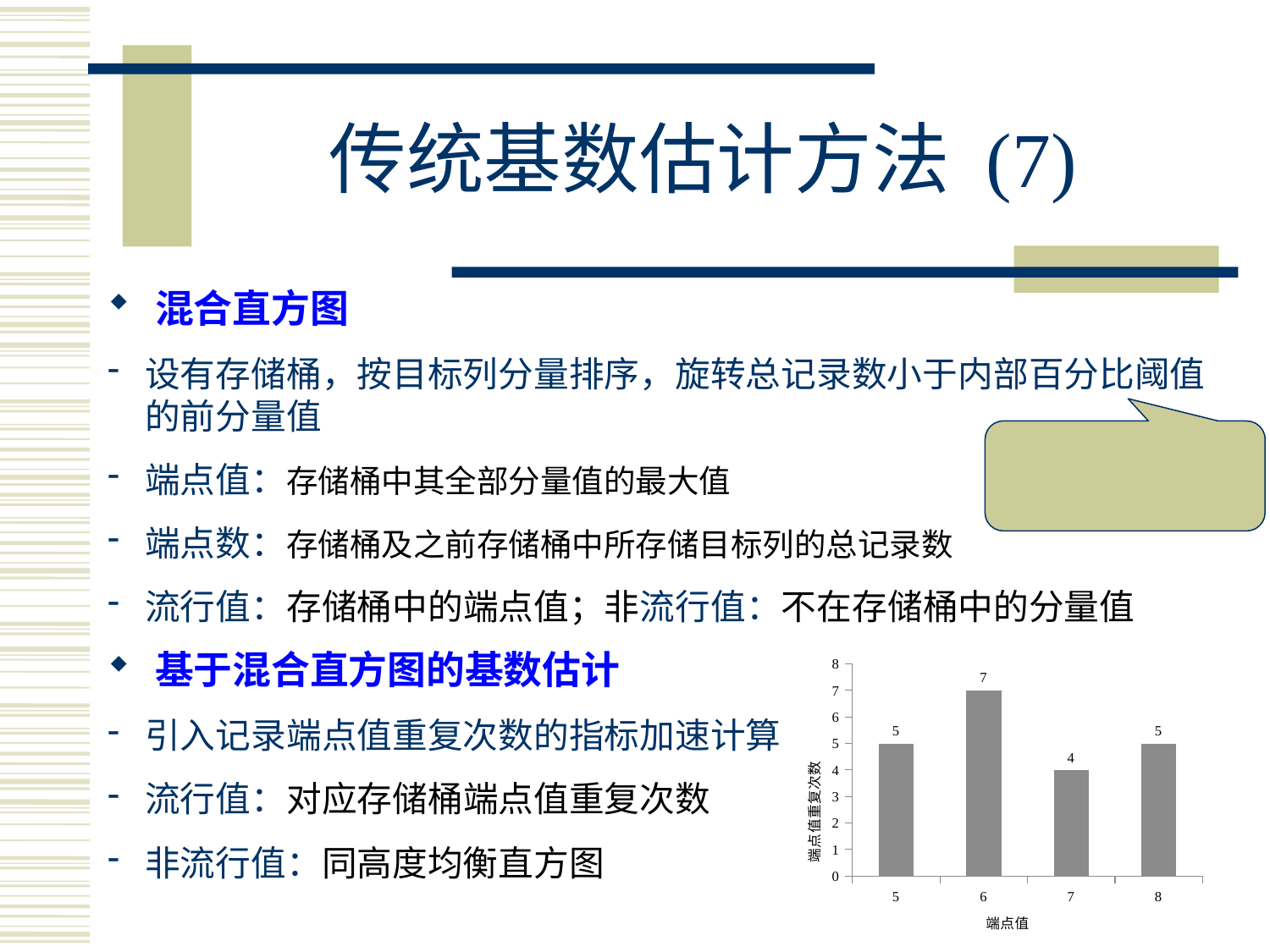
What is the difference between the values for 端点值 6 and 端点值 7? 3 What is the value for 端点值 6? 7 What is the value for 端点值 7? 4 How many bars (categories) does the chart show? 4 What is the value for 端点值 5? 5 What kind of chart is shown on the slide? bar chart What is the label of the x axis of the chart? 端点值 Which is larger, the value for 端点值 6 or the value for 端点值 8? 端点值 6 What is the label of the y axis of the chart? 端点值重复次数 Which 端点值 has the highest 端点值重复次数? 6 Is the value for 端点值 6 greater or less than 6? greater Which 端点值 has the lowest 端点值重复次数? 7